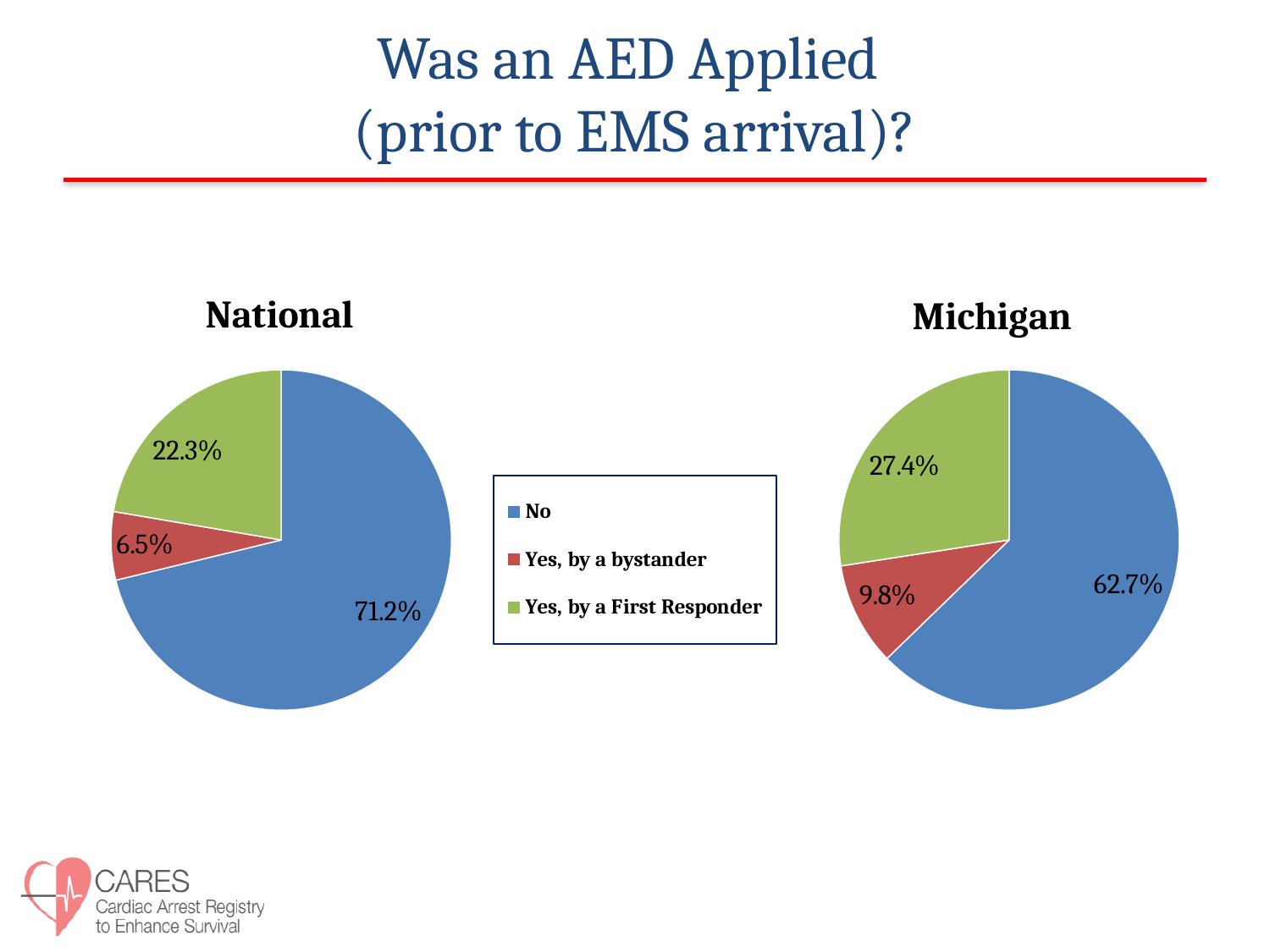
In the Michigan pie chart, what share of cases had an AED applied by a First Responder? 27.4% What is the difference between the 'No' share in the National chart and the 'No' share in the Michigan chart? 8.5% Which colour represents 'Yes, by a First Responder' in the pie charts? Green In the Michigan pie chart, which category has the largest slice? No How many categories does the legend list? 3 What type of chart is used for the National and Michigan data? Pie chart In the National pie chart, what share of cases had an AED applied by a First Responder? 22.3% In the Michigan pie chart, what share of cases had an AED applied by a bystander? 9.8% In the National pie chart, what share of cases had no AED applied? 71.2% Which chart shows a larger share for 'Yes, by a bystander', National or Michigan? Michigan What is the difference between the First Responder share in Michigan and the First Responder share in the National chart? 5.1% In the National pie chart, which category has the smallest slice? Yes, by a bystander